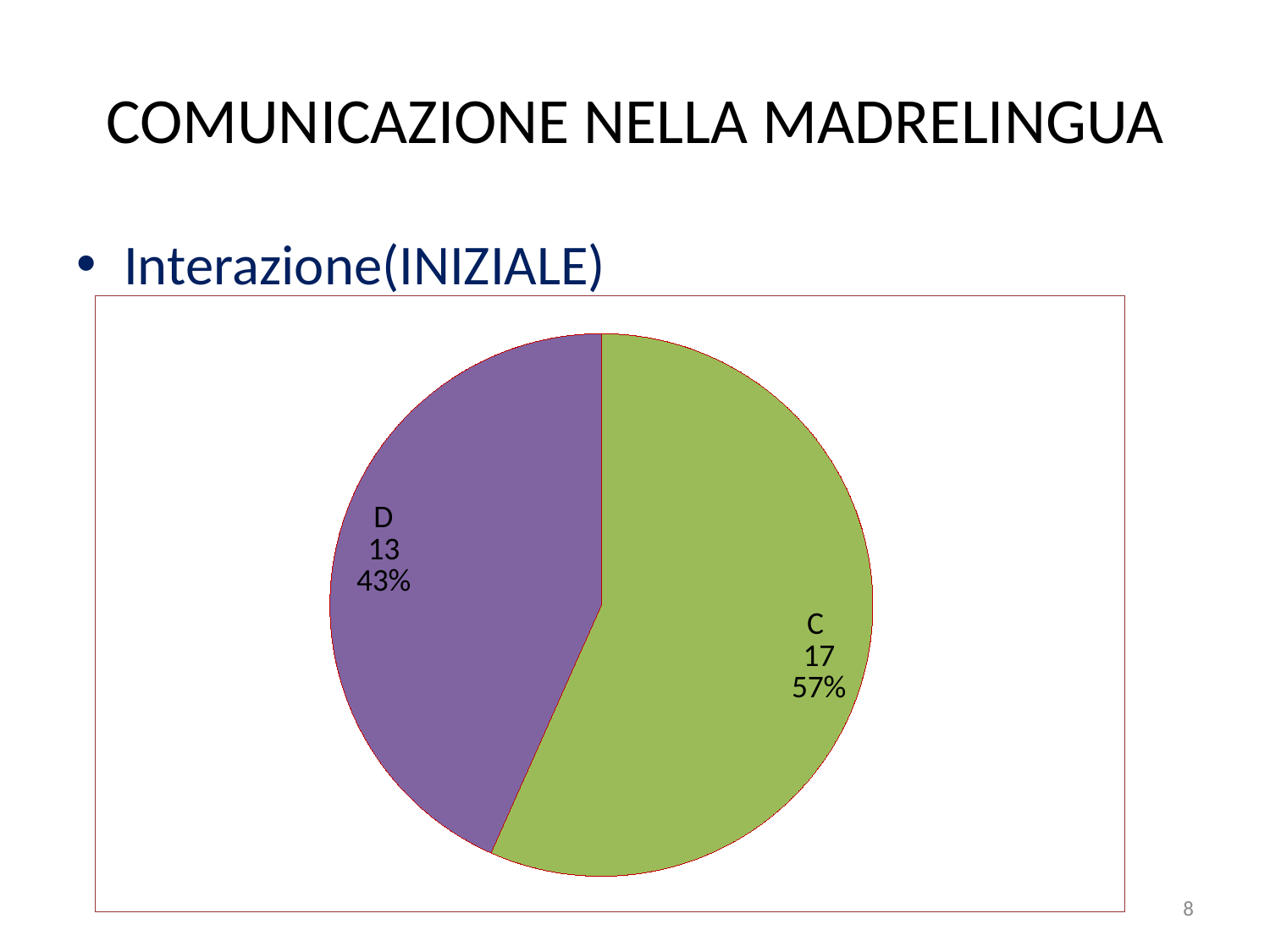
What is the difference between the values for C and D? 4 What percentage share does slice D have? 43% What is the value for category D? 13 Which category has the smallest slice? D What is the value for category C? 17 What percentage share does slice C have? 57% How many slices does the pie chart have? 2 Which is larger, the value for C or the value for D? C What colour is the slice for category D? purple Which category has the largest slice? C What is the total of the values shown in the pie chart? 30 What kind of chart is shown on the slide? pie chart